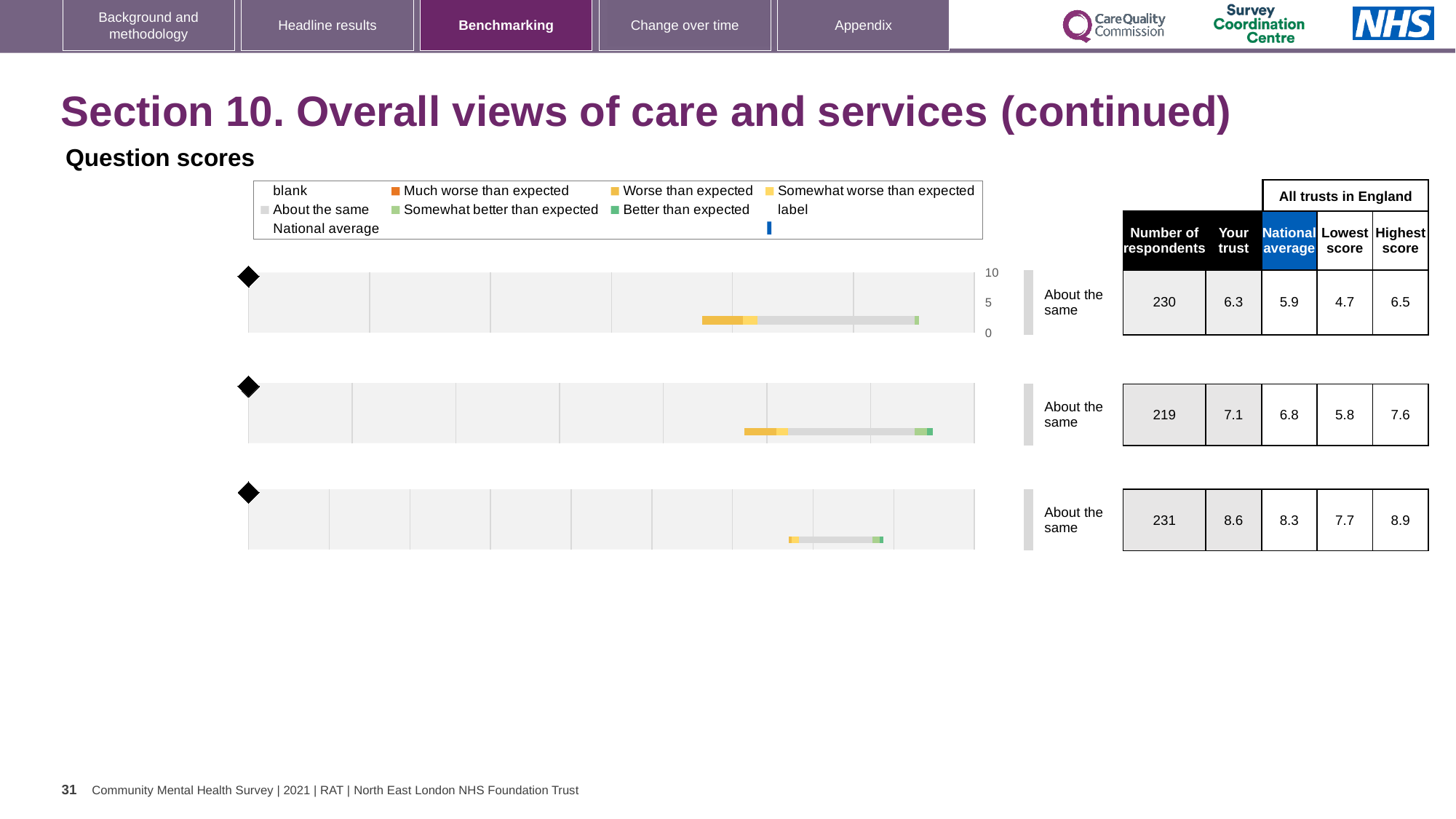
For the middle chart, which is larger: the 'Your trust' score or the national average? Your trust What benchmark category label is shown next to each of the three charts? About the same Which chart (top, middle or bottom) has the lowest number of respondents? middle Which chart (top, middle or bottom) has the highest 'Your trust' score? bottom For the bottom chart, how many respondents are listed in the table? 231 How many question score charts are shown on the slide? 3 For the bottom chart, what is the highest score among all trusts in England? 8.9 For the middle chart, what is the national average score shown in the table? 6.8 For the top chart, what is the difference between the 'Your trust' score and the national average? 0.4 For the bottom chart, what is the difference between the highest score and the lowest score among all trusts in England? 1.2 What kind of chart is used for the question scores on this slide? bar chart For the top chart, what is the 'Your trust' score shown in the table? 6.3